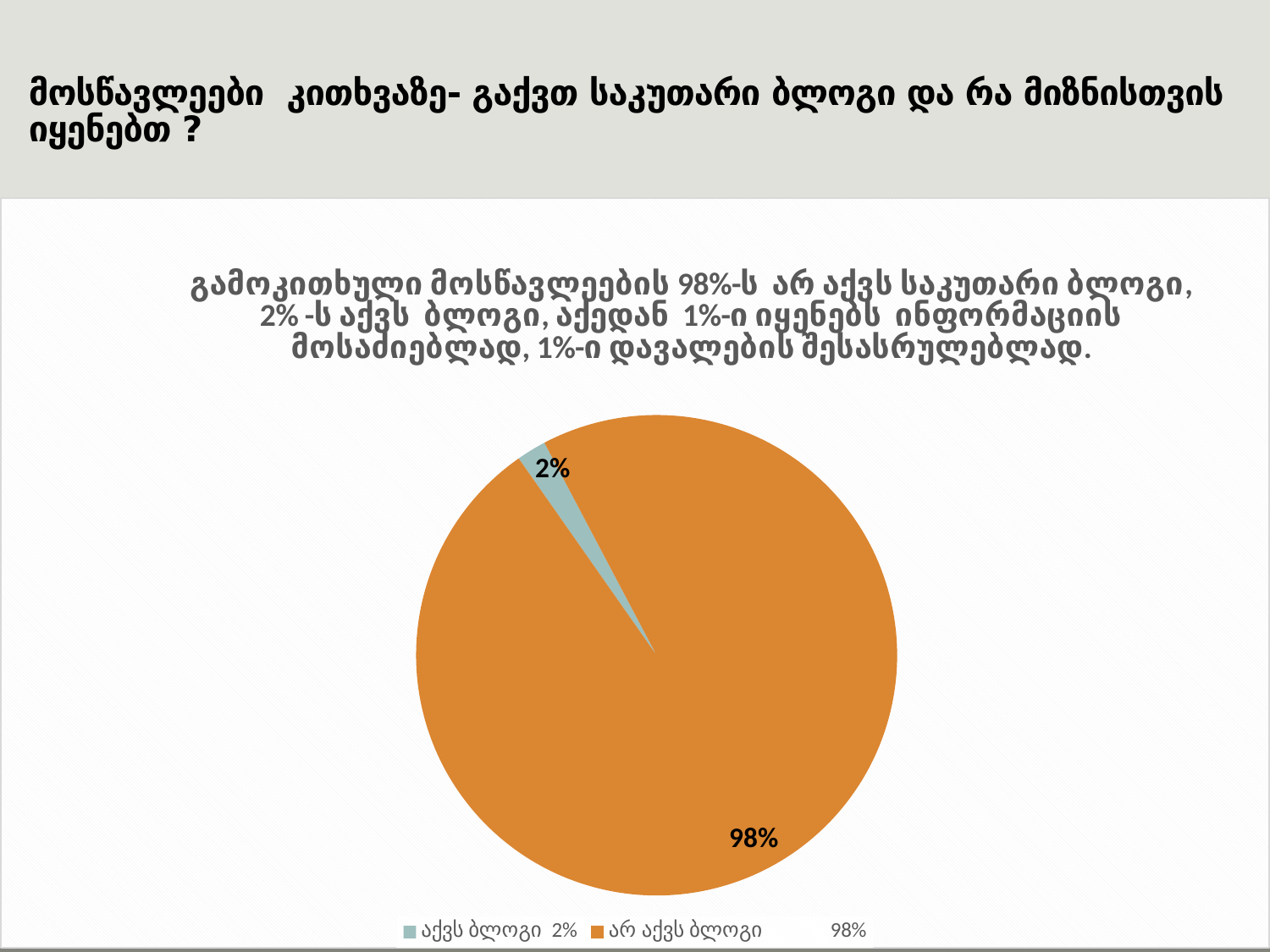
What kind of chart is shown on the slide? pie chart What share of the pie does the slice labelled "არ აქვს ბლოგი" represent? 98% What colour is the slice labelled "არ აქვს ბლოგი" in the pie chart? orange What is the difference in percentage points between the "არ აქვს ბლოგი" slice and the "აქვს ბლოგი" slice? 96 What share of the pie does the slice labelled "აქვს ბლოგი" represent? 2% Which is larger, the "აქვს ბლოგი" slice or the "არ აქვს ბლოგი" slice? არ აქვს ბლოგი What is the data label shown on the large slice of the pie chart? 98% Which slice of the pie chart is the smallest? აქვს ბლოგი How many entries does the legend of the pie chart list? 2 Which slice of the pie chart is the largest? არ აქვს ბლოგი How many slices does the pie chart have? 2 What is the data label shown on the small slice of the pie chart? 2%